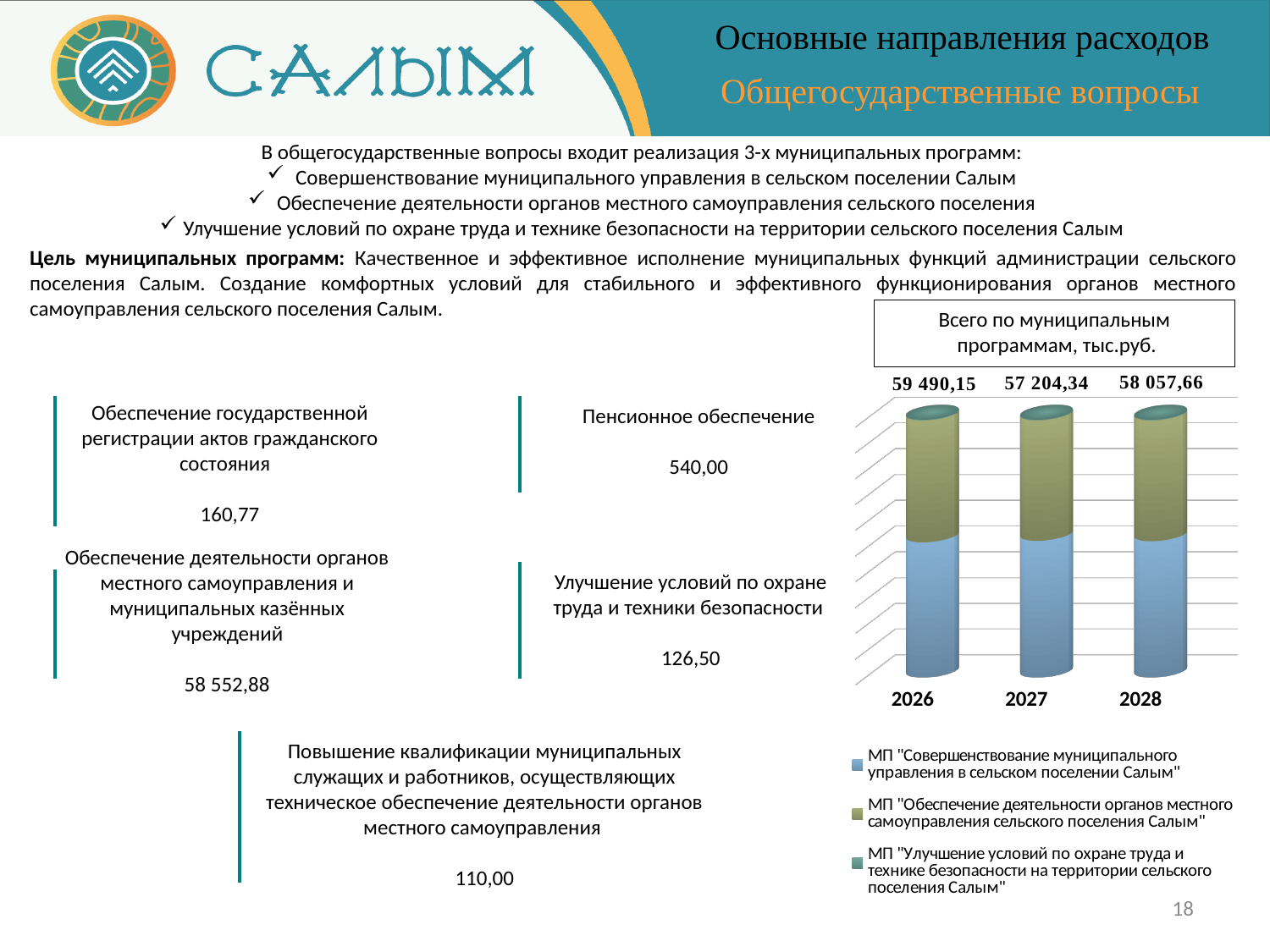
How many years (categories) are shown on the x axis of the chart? 3 Does the total rise or fall from 2026 to 2027 in the chart? Fall By how much does the 2026 total exceed the 2027 total in the chart? 2 285,81 Which year has the highest total in the chart 'Всего по муниципальным программам, тыс.руб.'? 2026 What kind of chart is shown on the slide? Stacked bar chart How many series does the legend of the chart list? 3 What is the difference between the 2028 total and the 2027 total in the chart? 853,32 What is the total value shown above the 2026 bar in the chart 'Всего по муниципальным программам, тыс.руб.'? 59 490,15 What is the total value shown above the 2028 bar in the chart? 58 057,66 What is the total value shown above the 2027 bar in the chart? 57 204,34 Which year has the lowest total in the chart? 2027 Which is larger in the chart: the total for 2028 or the total for 2027? 2028